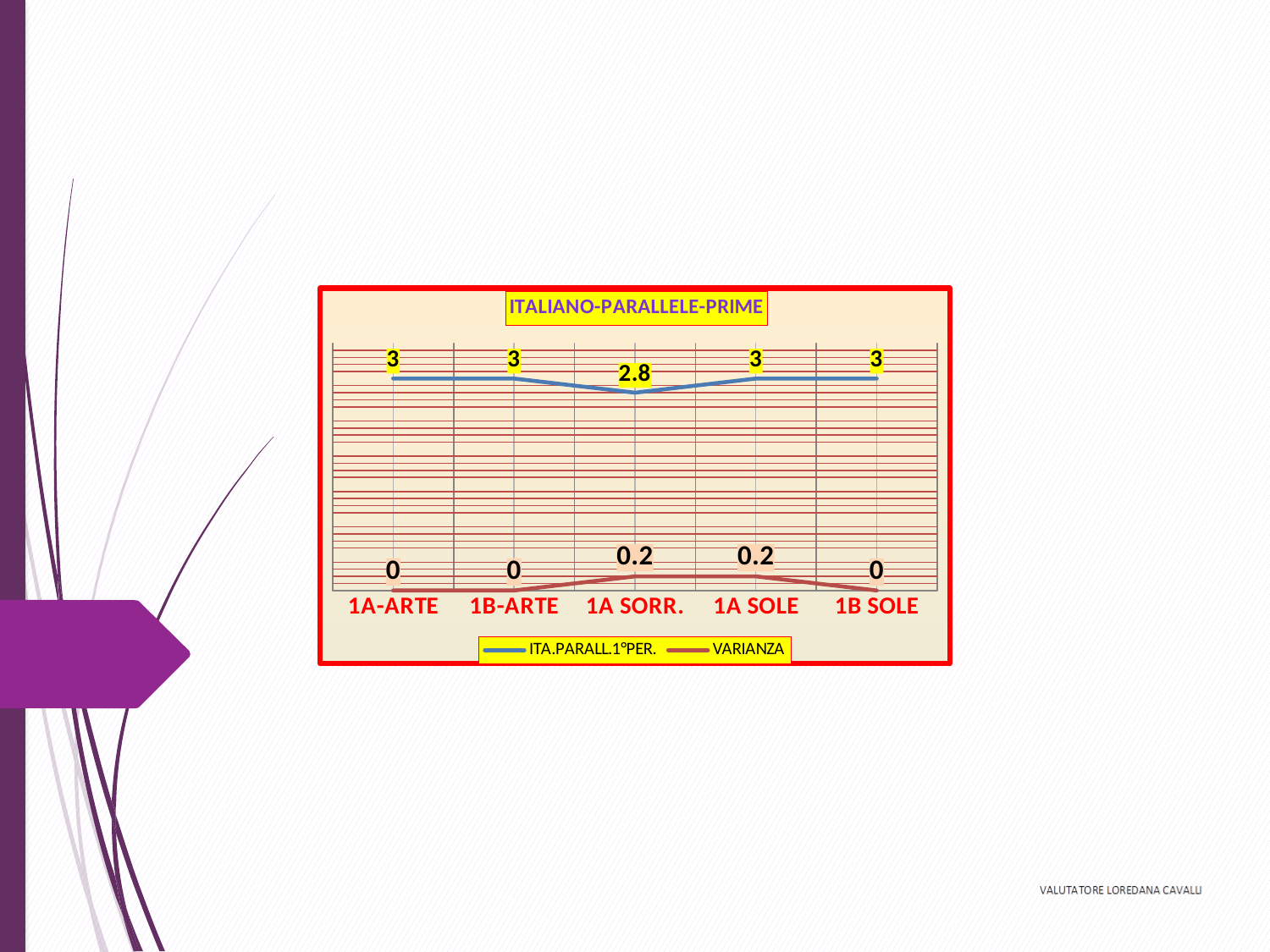
What is the title of the chart? ITALIANO-PARALLELE-PRIME Which series is drawn in blue in the legend? ITA.PARALL.1°PER. What is the VARIANZA value for 1A SOLE? 0.2 What is the ITA.PARALL.1°PER. value for 1B SOLE? 3 Which category has the lowest ITA.PARALL.1°PER. value? 1A SORR. What is the difference between the ITA.PARALL.1°PER. values for 1A-ARTE and 1A SORR.? 0.2 Which is larger, the VARIANZA value for 1A SORR. or for 1B SOLE? 1A SORR. How many series does the legend list? 2 What is the VARIANZA value for 1B-ARTE? 0 How many categories are shown on the x axis? 5 What is the ITA.PARALL.1°PER. value for 1A SORR.? 2.8 What kind of chart is shown on the slide? line chart